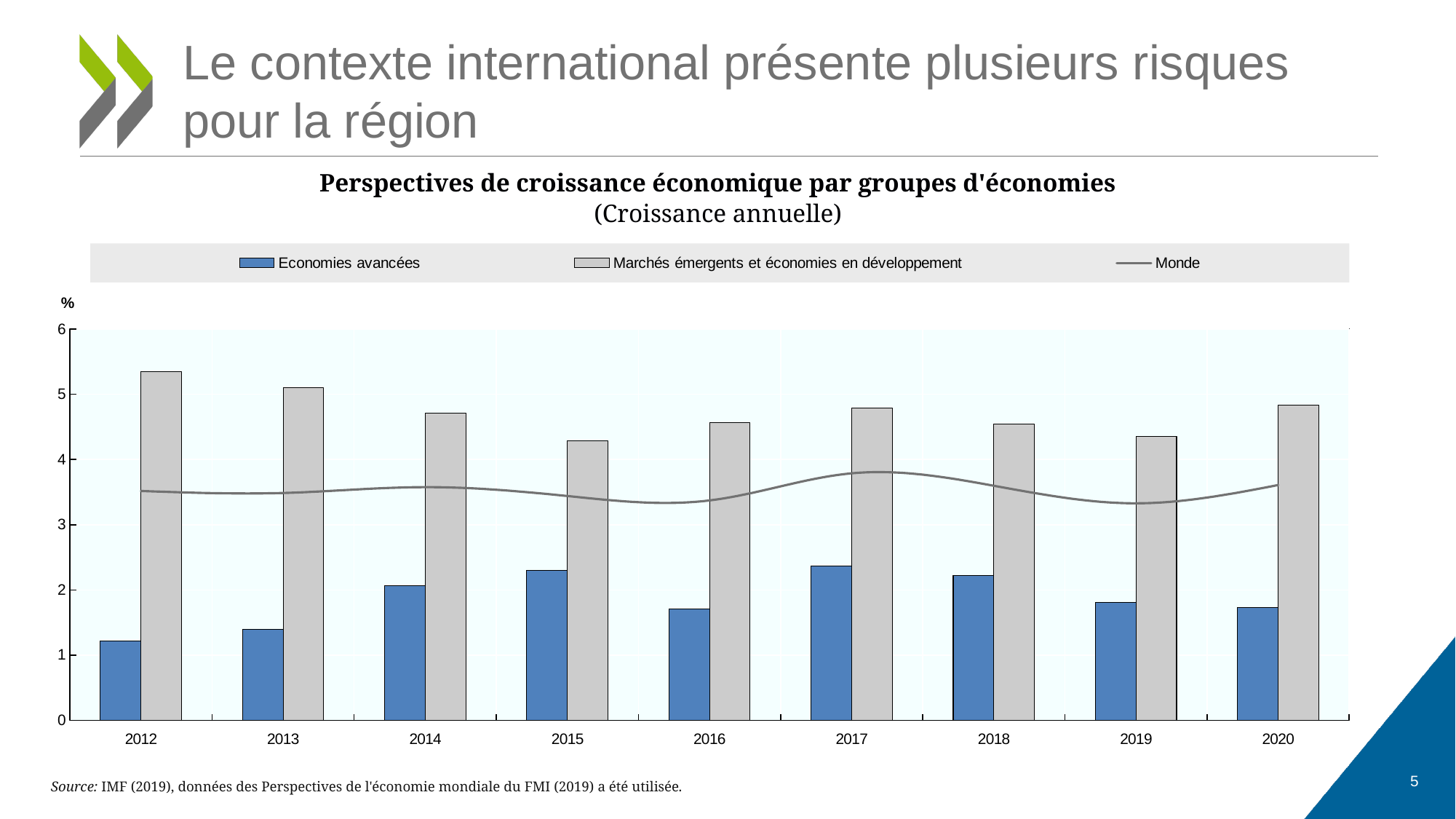
Is the value for Economies avancées in 2012 greater or less than 2? less How many series does the legend list? 3 In which year is the value for Economies avancées lowest? 2012 In which year is the value for Marchés émergents et économies en développement highest? 2012 What kind of chart is shown on the slide? bar chart with a line Is the value for Marchés émergents et économies en développement in 2015 greater or less than 5? less How many years are shown on the x axis? 9 Which is larger for Marchés émergents et économies en développement: 2013 or 2014? 2013 Is the Monde value in 2019 greater or less than 4? less Do the values for Marchés émergents et économies en développement rise or fall from 2012 to 2015? fall